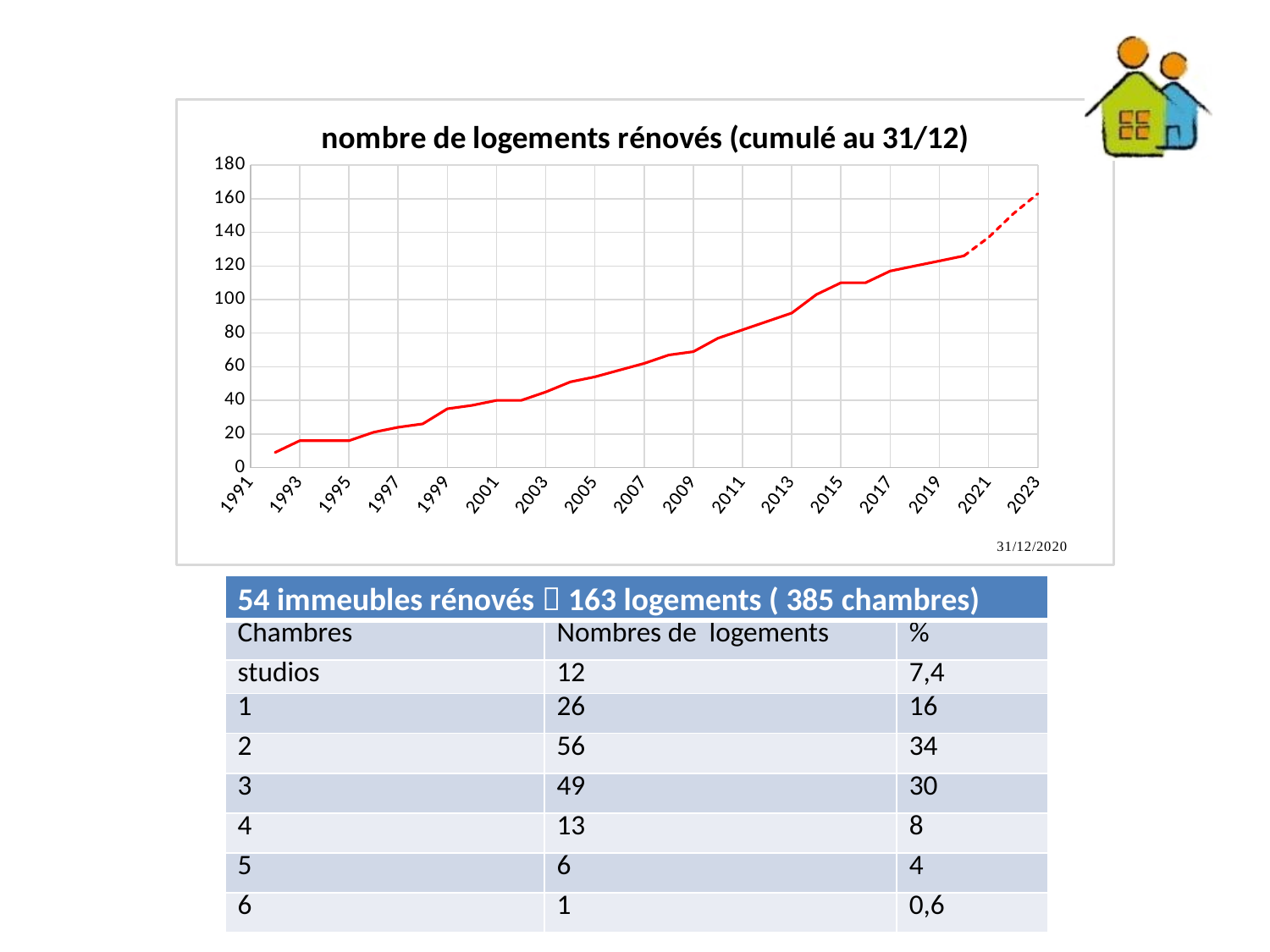
Is the value for 1993 greater or less than 20? less Is the value for 2013 greater or less than 80? greater Is the value for 2023 greater or less than 140? greater Do the values in the chart rise or fall from 1991 to 2023? rise What kind of chart is shown on the slide? line chart How many year labels are shown on the x axis? 17 What colour is the line in the chart? red In which year does the line reach its highest value? 2023 What is the title of the chart? nombre de logements rénovés (cumulé au 31/12)